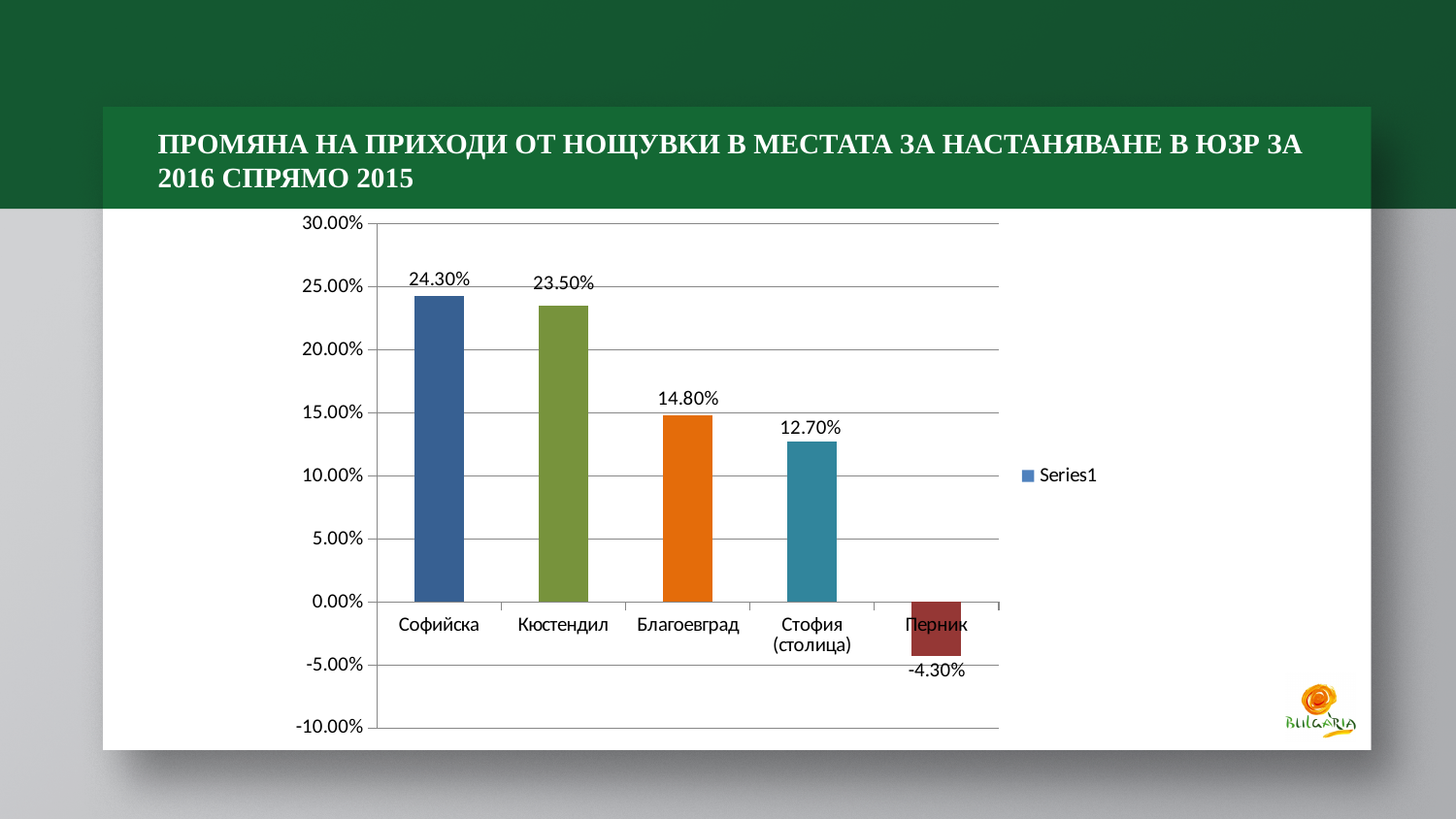
What is the value for Кюстендил? 23.50% Which category has the highest value? Софийска Which is larger, the value for Благоевград or the value for Стофия (столица)? Благоевград What kind of chart is shown on the slide? Bar chart What is the value for Софийска? 24.30% What is the value for Перник? -4.30% How many categories are shown on the x axis? 5 Which category has the lowest value? Перник What is the only entry listed in the legend? Series1 What is the value for Стофия (столица)? 12.70% What is the difference between the values for Софийска and Благоевград? 9.50% What is the value for Благоевград? 14.80%